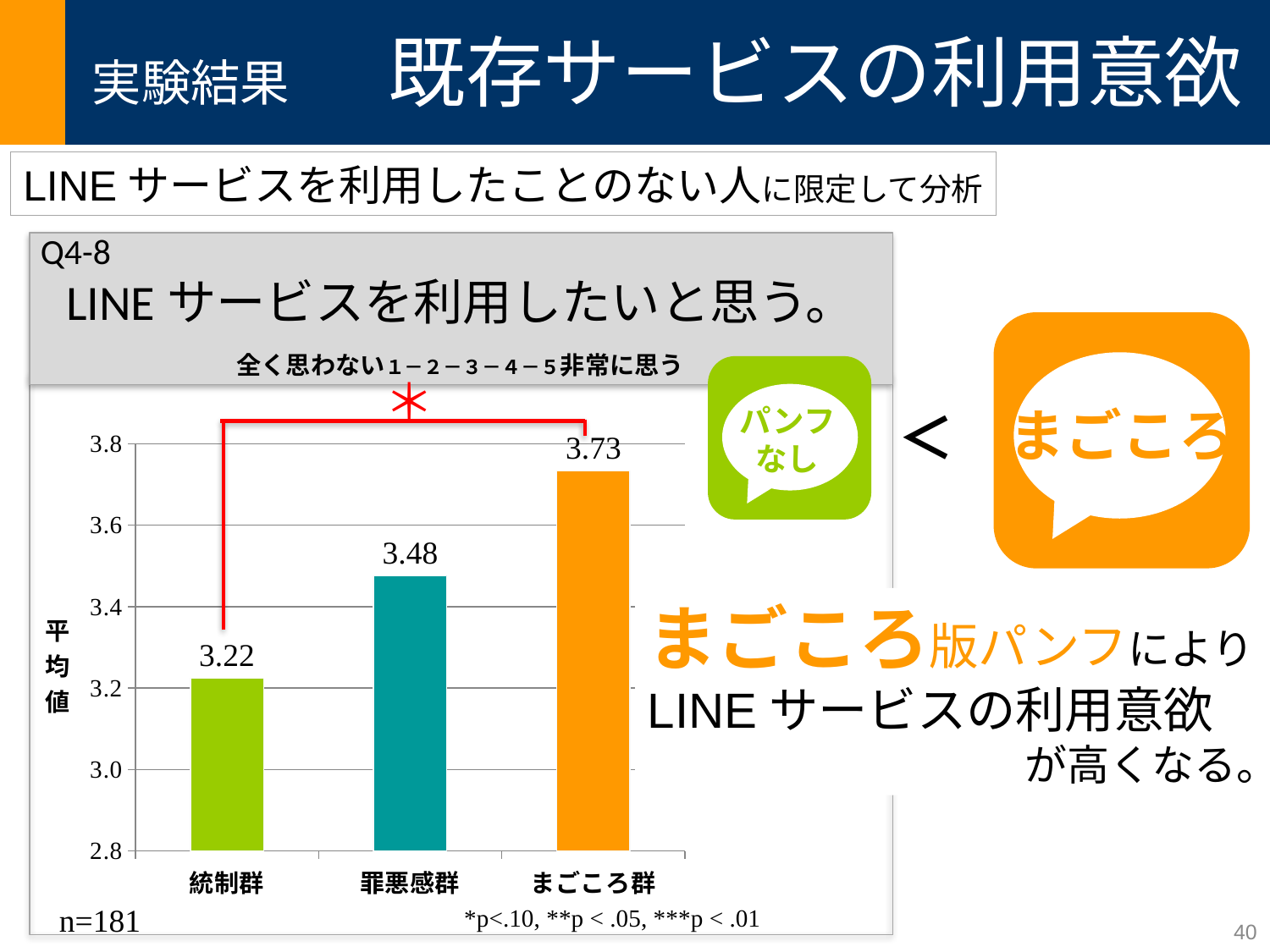
What kind of chart is shown? bar chart Which group has the lowest value? 統制群 What is the value for まごころ群? 3.73 Which is larger, the value for 罪悪感群 or the value for まごころ群? まごころ群 How many groups are shown on the x axis? 3 What is the sample size (n) shown below the chart? n=181 What is the difference between the values for まごころ群 and 統制群? 0.51 Which group has the highest value? まごころ群 Is the value for 統制群 greater or less than 3.4? less What is the difference between the values for 罪悪感群 and 統制群? 0.26 What is the value for 統制群? 3.22 What is the value for 罪悪感群? 3.48